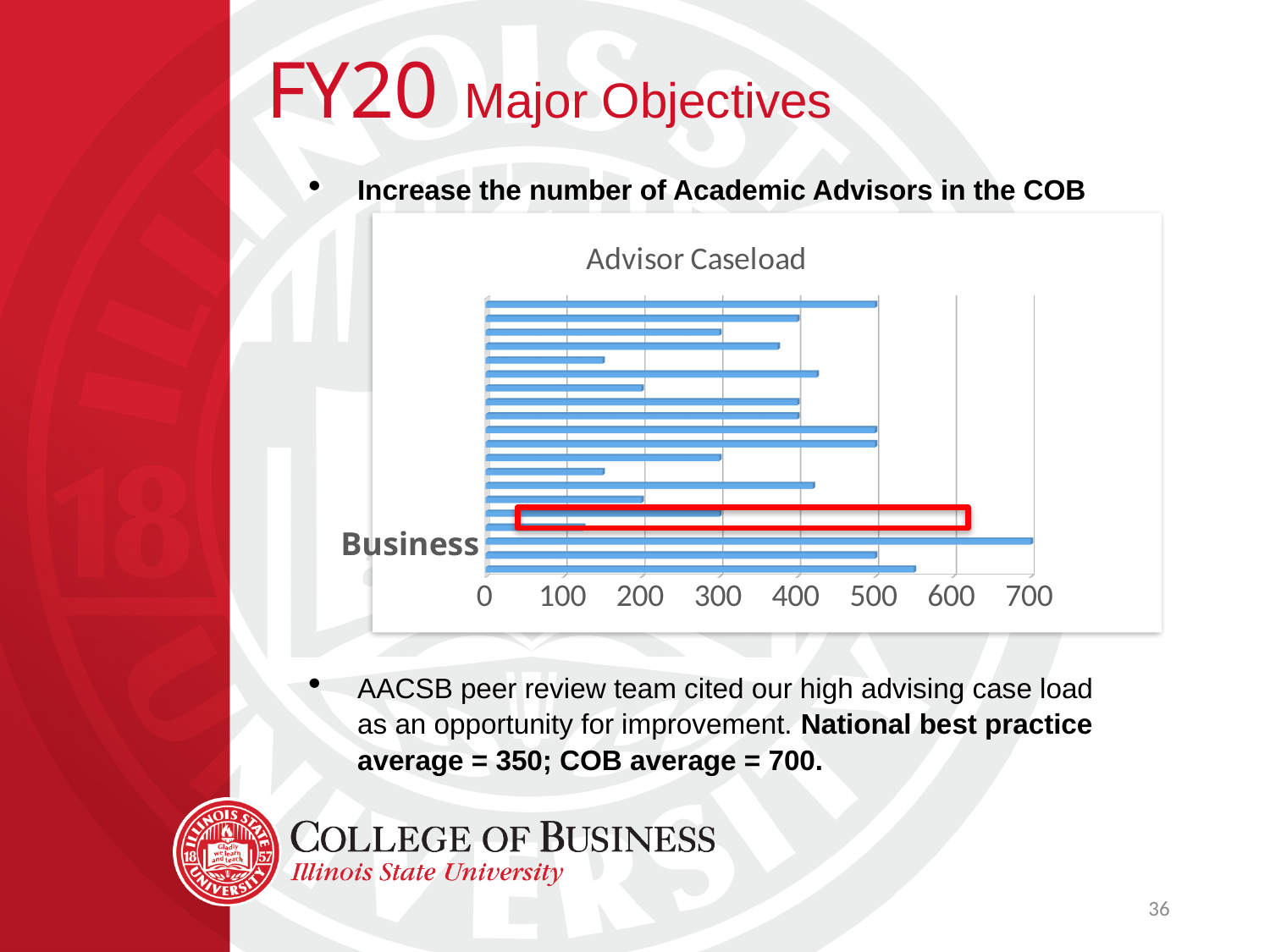
Which category label is readable on the y axis of the Advisor Caseload chart? Business What is the highest value shown on the x axis of the Advisor Caseload chart? 700 What kind of chart is shown on the slide? bar chart Are the bars in the Advisor Caseload chart horizontal or vertical? horizontal Which labeled category has the longest bar in the Advisor Caseload chart? Business Is the value for Business greater or less than 600? greater Is the value for Business greater or less than 500? greater